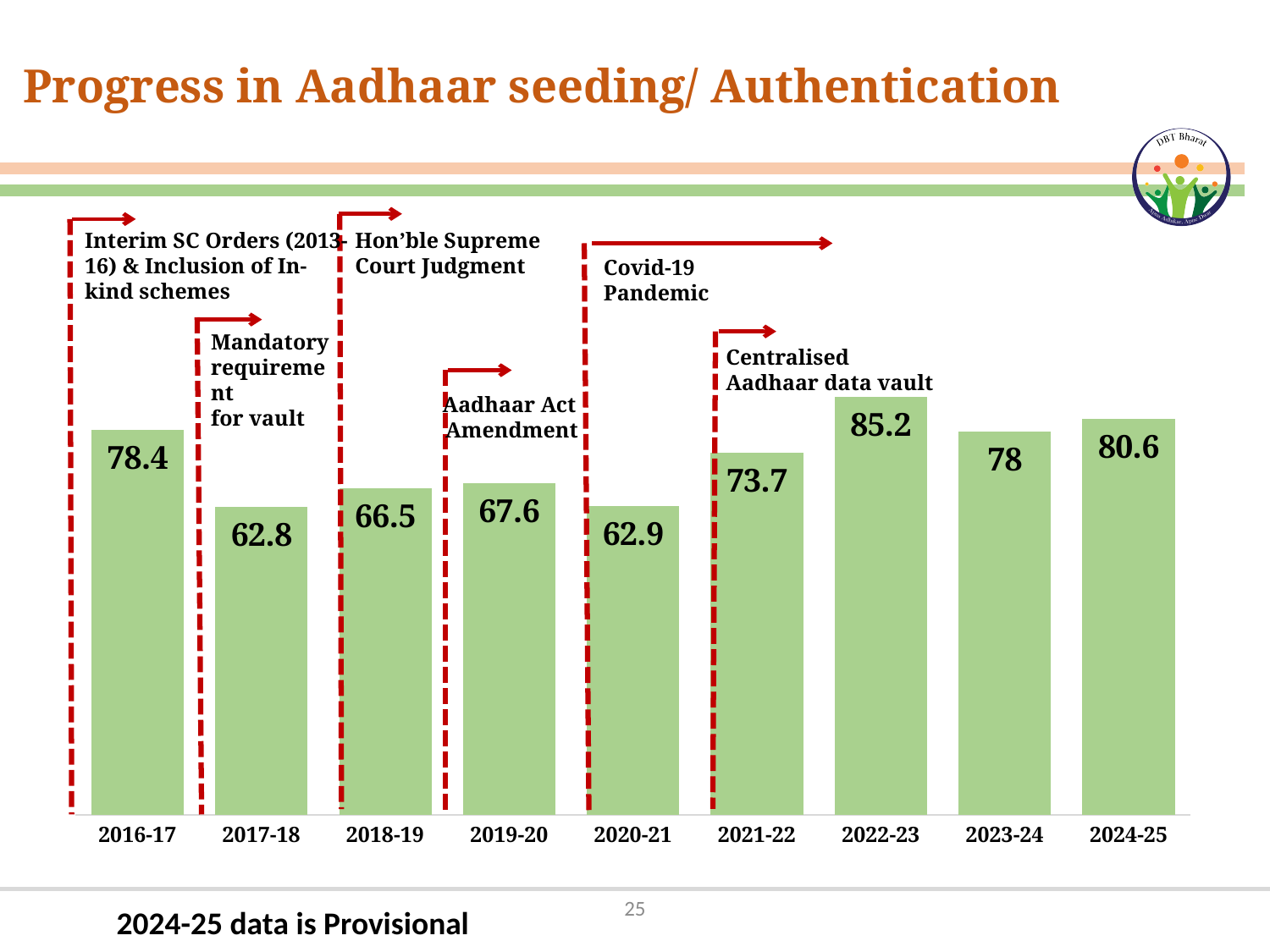
How many years are shown on the x axis? 9 Which year has the highest value? 2022-23 Which is larger, the value for 2018-19 or the value for 2019-20? 2019-20 Which year has the lowest value? 2017-18 Do the values rise or fall from 2020-21 to 2022-23? Rise What is the title of the slide containing the chart? Progress in Aadhaar seeding/ Authentication What is the difference between the values for 2024-25 and 2023-24? 2.6 What is the difference between the values for 2022-23 and 2021-22? 11.5 What is the value for 2016-17? 78.4 What is the value for 2022-23? 85.2 What is the value for 2020-21? 62.9 What kind of chart is shown on the slide? Bar chart